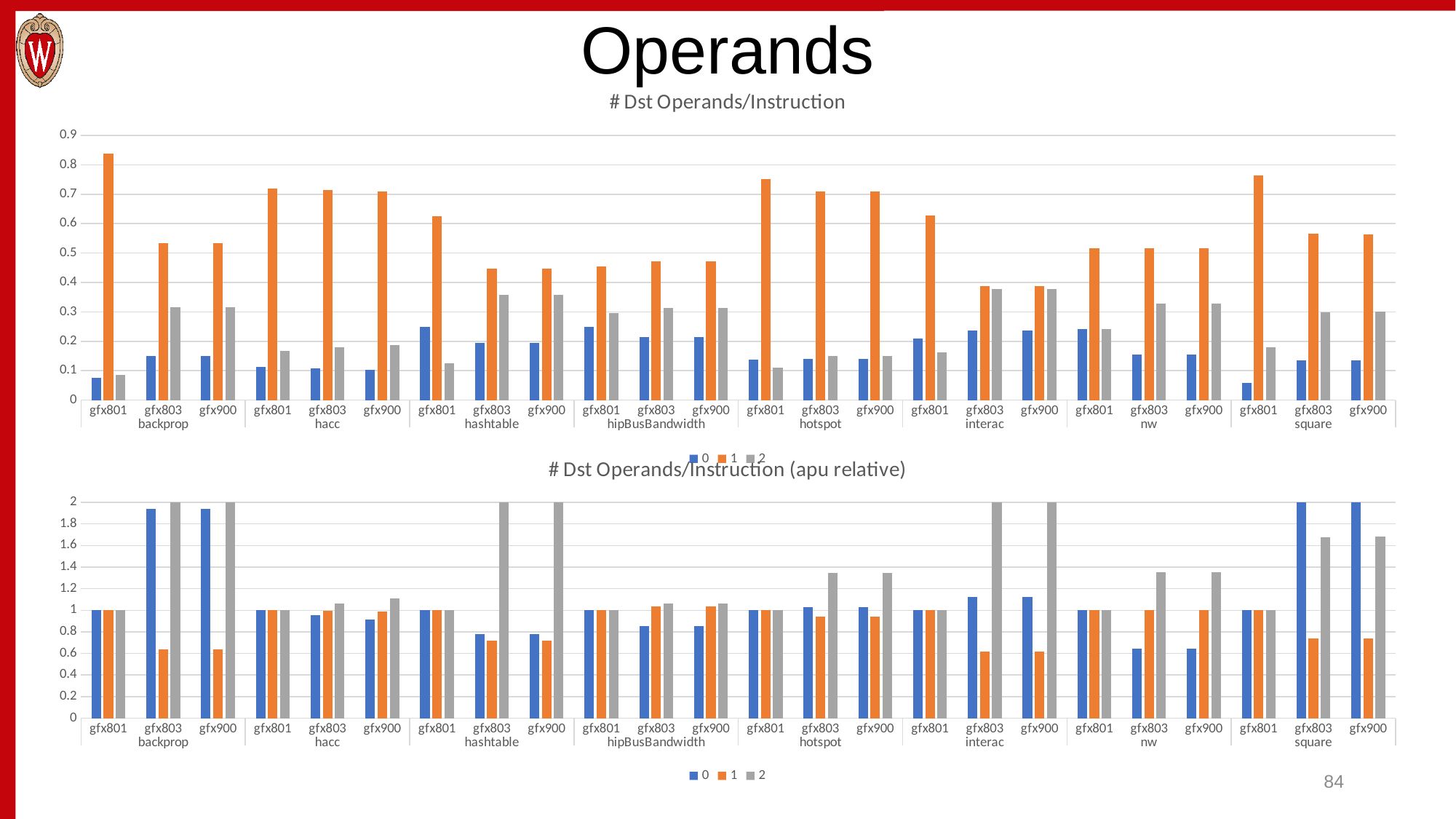
In the top chart '# Dst Operands/Instruction', what are the legend entries? 0, 1, 2 In the top chart '# Dst Operands/Instruction', which GPU/benchmark has the highest value for series 1? gfx801 backprop In the bottom chart '# Dst Operands/Instruction (apu relative)', what is the value of series 1 for gfx801 under backprop? 1 What kind of chart is the top chart titled '# Dst Operands/Instruction'? bar chart How many series does the legend of the top chart '# Dst Operands/Instruction' list? 3 In the top chart '# Dst Operands/Instruction', is the value of series 0 for gfx801 under square greater or less than 0.1? less In the bottom chart '# Dst Operands/Instruction (apu relative)', is the value of series 0 for gfx803 under backprop greater or less than 1.8? greater In the top chart '# Dst Operands/Instruction', which is larger for series 1: gfx801 under backprop or gfx801 under hotspot? gfx801 under backprop What is the title of the bottom chart? # Dst Operands/Instruction (apu relative) In the top chart '# Dst Operands/Instruction', how many benchmark groups are shown along the x axis? 8 In the bottom chart '# Dst Operands/Instruction (apu relative)', is the value of series 1 for gfx803 under interac greater or less than 0.8? less